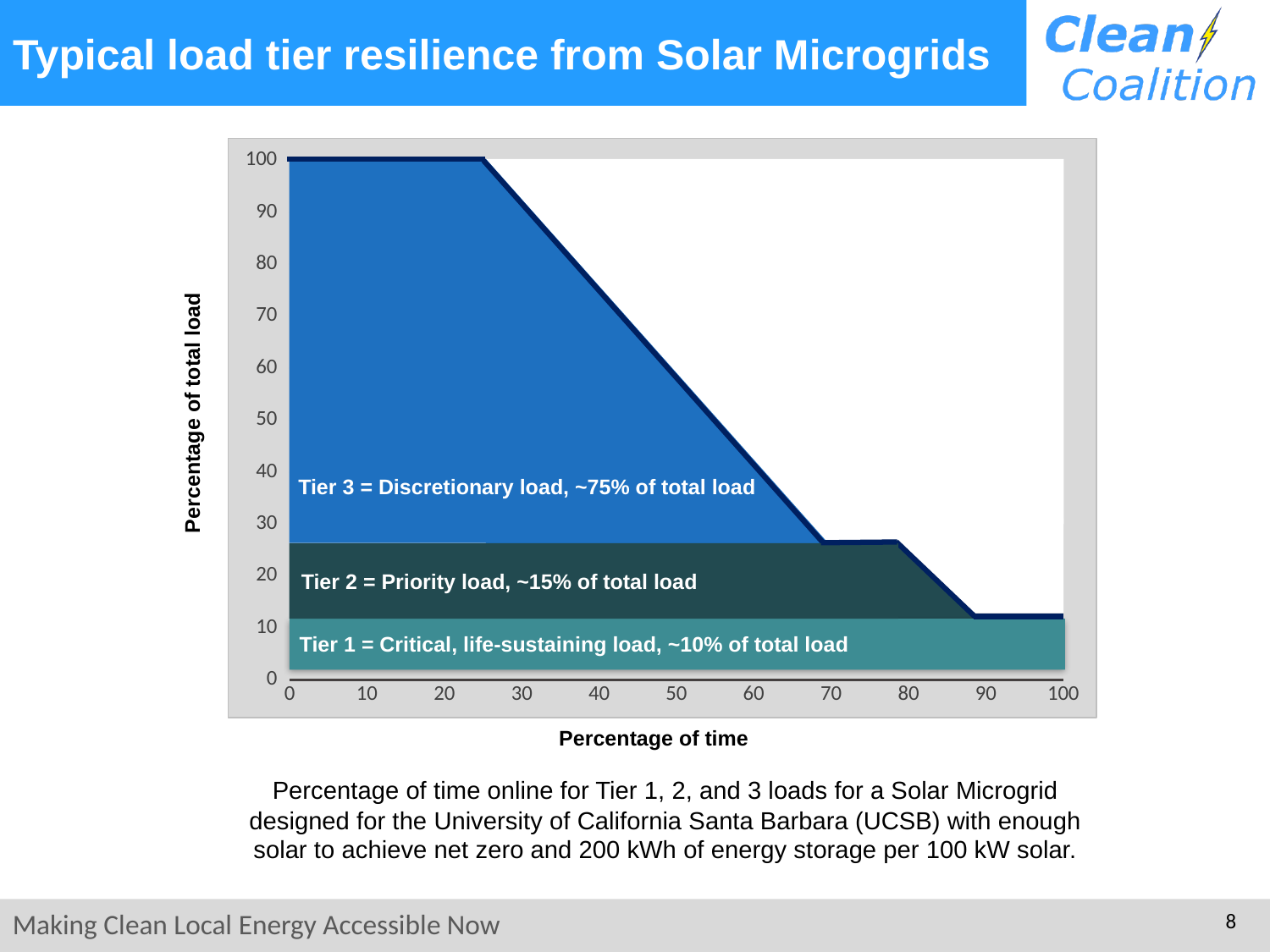
What is the title of the chart's vertical axis? Percentage of total load According to the label on the chart, what share of total load is Tier 2 (Priority load)? ~15% What kind of chart is shown on the slide? Area chart What percentage of total load is online at 10% of time? 100 According to the label on the chart, what share of total load is Tier 1 (Critical, life-sustaining load)? ~10% Is the percentage of total load online at 50% of time greater or less than 50? greater Is the percentage of total load online at 40% of time greater or less than 70? greater Does the percentage of total load online rise or fall as the percentage of time increases along the x axis? Fall How many load tiers are labelled on the chart? 3 Is the percentage of total load online at 100% of time greater or less than 20? less According to the label on the chart, what share of total load is Tier 3 (Discretionary load)? ~75% What is the title of the chart's horizontal axis? Percentage of time